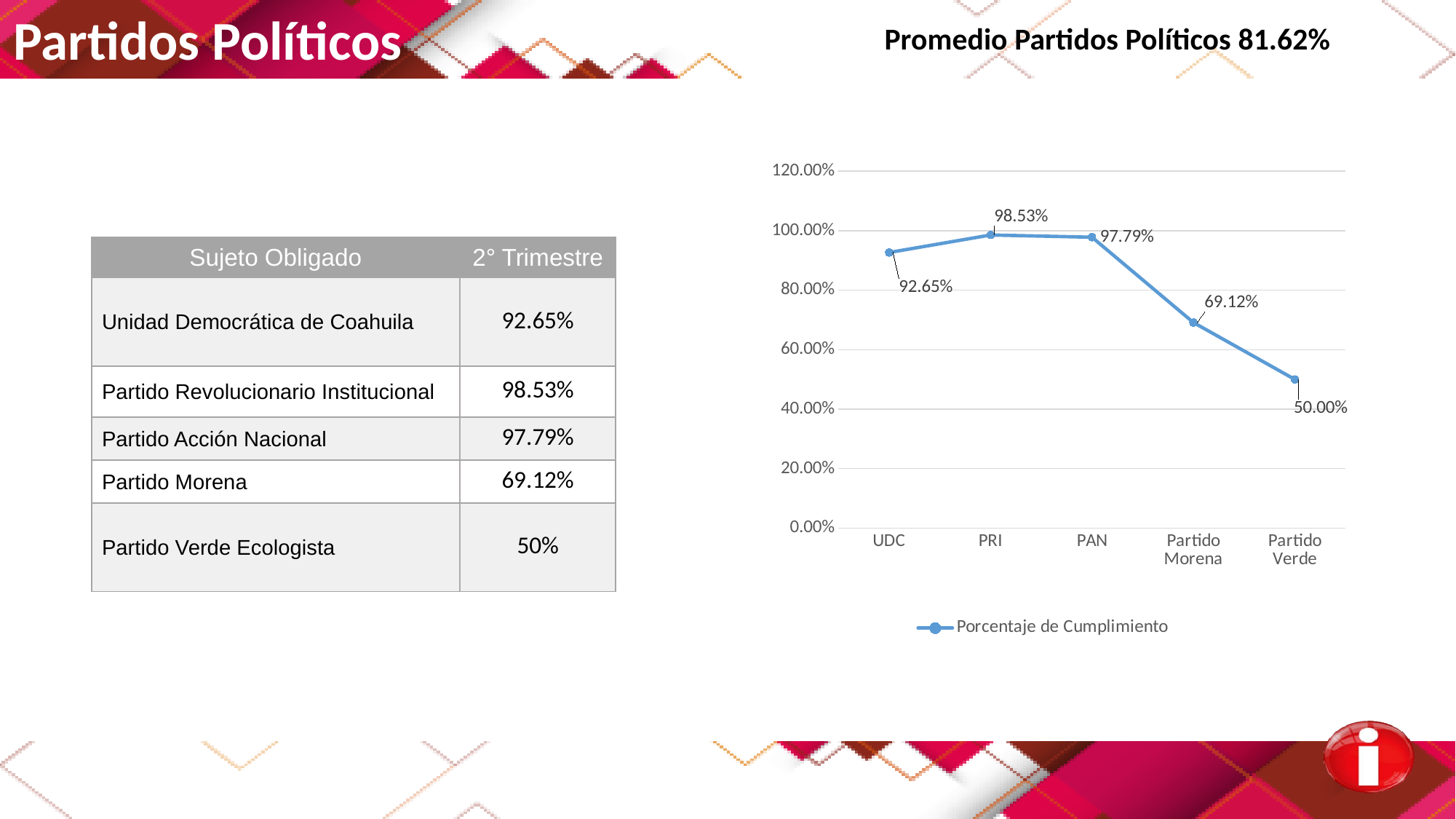
Which category has the highest value in the line chart? PRI Which is larger in the line chart, the value for UDC or the value for Partido Verde? UDC Is the value for Partido Morena in the line chart greater or less than 80.00%? less How many categories are plotted on the x axis of the line chart? 5 What is the difference between the values for PAN and Partido Morena in the line chart? 28.67% How many series does the legend of the line chart list? 1 Which category has the lowest value in the line chart? Partido Verde What is the name of the series shown in the legend of the line chart? Porcentaje de Cumplimiento What is the value for PRI in the line chart? 98.53% What is the value for Partido Morena in the line chart? 69.12% What kind of chart is shown on the slide? line chart What is the value for UDC in the line chart? 92.65%